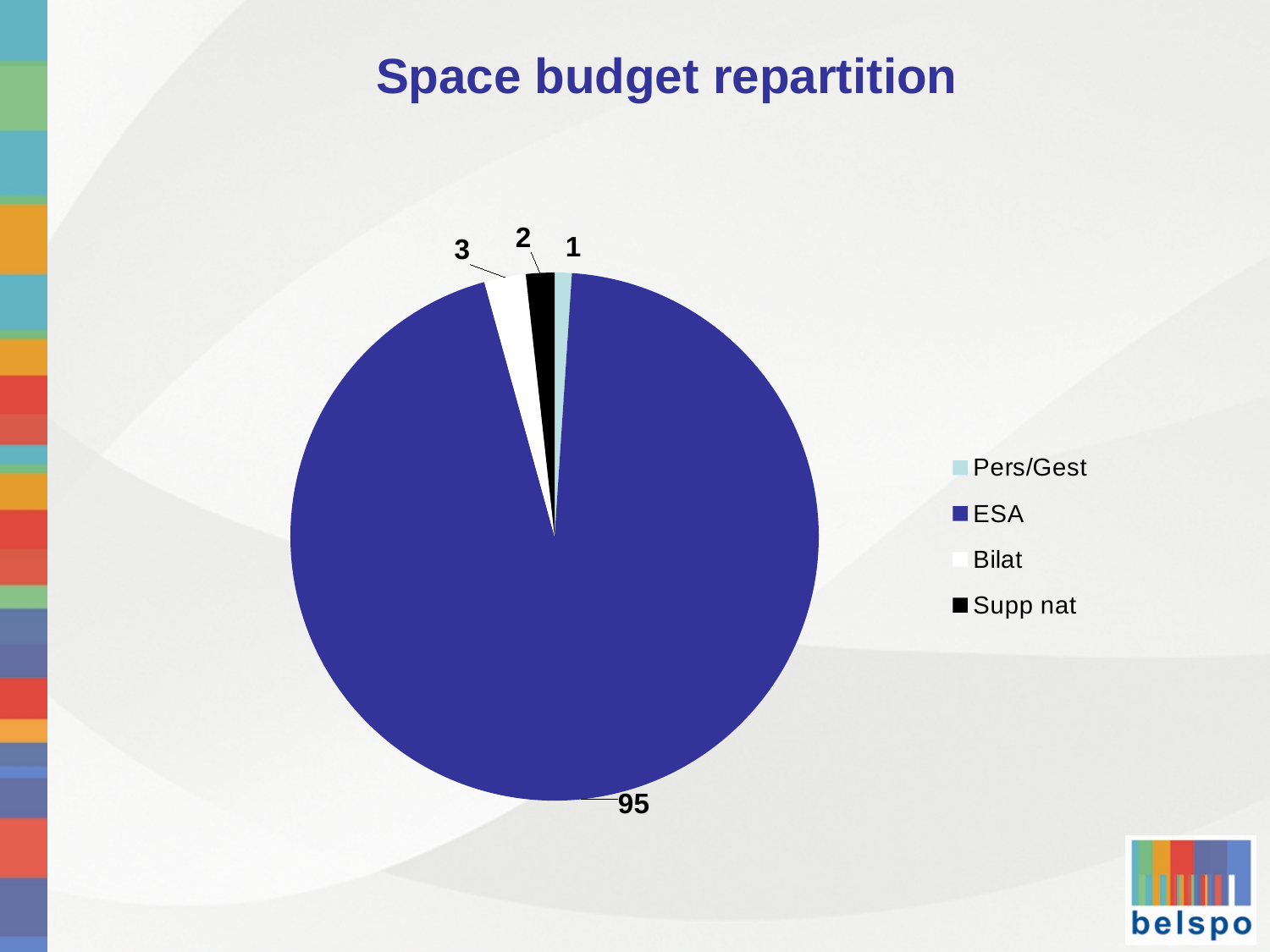
What is the difference between the values for ESA and Bilat? 92 How many categories does the legend list? 4 Which colour represents Supp nat in the chart? black Which category has the smallest slice of the pie? Pers/Gest What is the value for Pers/Gest? 1 What kind of chart is shown on the slide? pie chart What is the title of the chart? Space budget repartition Which is larger, the value for Bilat or the value for Supp nat? Bilat What is the value for Supp nat? 2 What is the value for ESA? 95 Which category has the largest slice of the pie? ESA What is the value for Bilat? 3